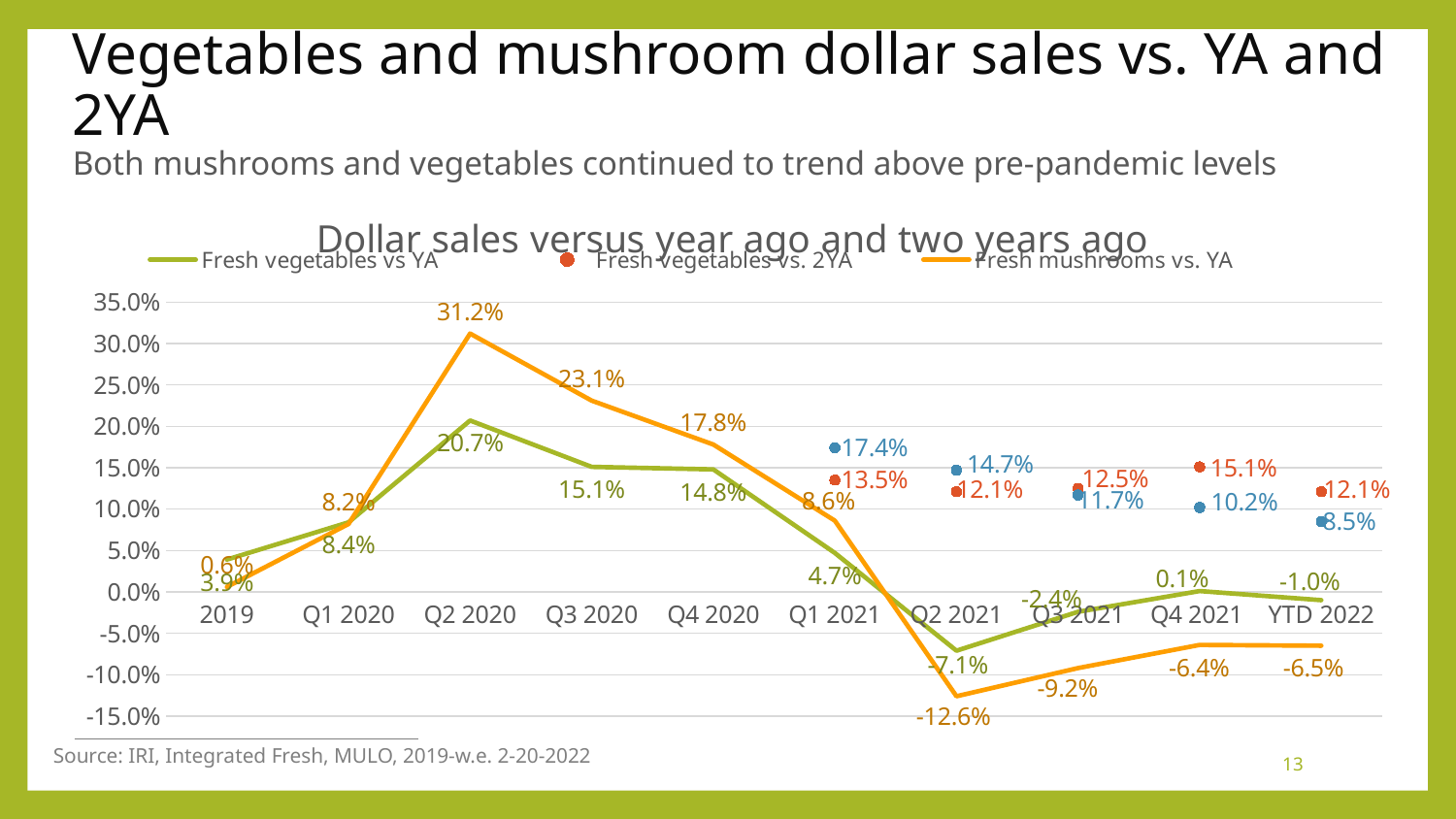
What is the value for Fresh vegetables vs. 2YA in Q4 2021? 15.1% What is the value for Fresh vegetables vs YA in Q2 2021? -7.1% What is the value for Fresh mushrooms vs. YA in Q2 2020? 31.2% In which period is Fresh mushrooms vs. YA highest? Q2 2020 Does Fresh mushrooms vs. YA rise or fall from Q2 2020 to Q2 2021? Fall How many periods are shown on the x axis? 10 In which period is Fresh mushrooms vs. YA lowest? Q2 2021 What kind of chart is this? Line chart In which period is Fresh vegetables vs YA highest? Q2 2020 In Q2 2020, how much higher is Fresh mushrooms vs. YA than Fresh vegetables vs YA? 10.5 percentage points How many series does the legend list? 3 In Q3 2020, which is larger: Fresh vegetables vs YA or Fresh mushrooms vs. YA? Fresh mushrooms vs. YA